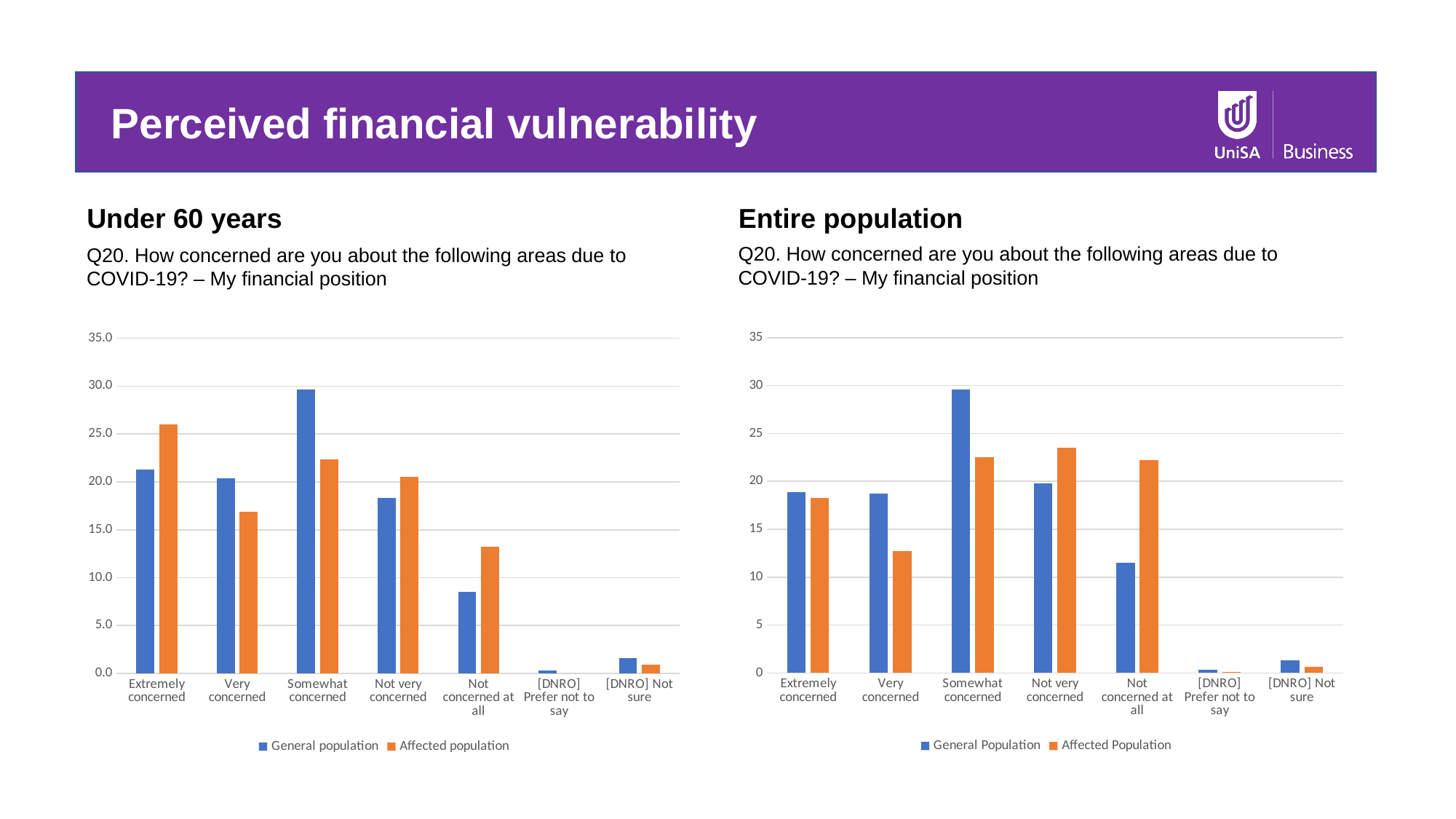
In the Entire population chart, which category has the highest General Population bar? Somewhat concerned In the Entire population chart, which is larger for Not concerned at all: General Population or Affected Population? Affected Population In the Under 60 years chart, which category has the highest General population bar? Somewhat concerned In the Entire population chart, is the Affected Population value for Very concerned greater or less than 15? less In the Under 60 years chart, which category has the highest Affected population bar? Extremely concerned How many series does the legend of the Entire population chart list? 2 In the Under 60 years chart, is the Affected population value for Not concerned at all greater or less than 15.0? less In the Under 60 years chart, is the General population value for Somewhat concerned greater or less than 25.0? greater How many categories are shown on the x axis of the Under 60 years chart? 7 What type of chart is the Entire population chart? Bar chart In the Under 60 years chart, which is larger for Extremely concerned: General population or Affected population? Affected population